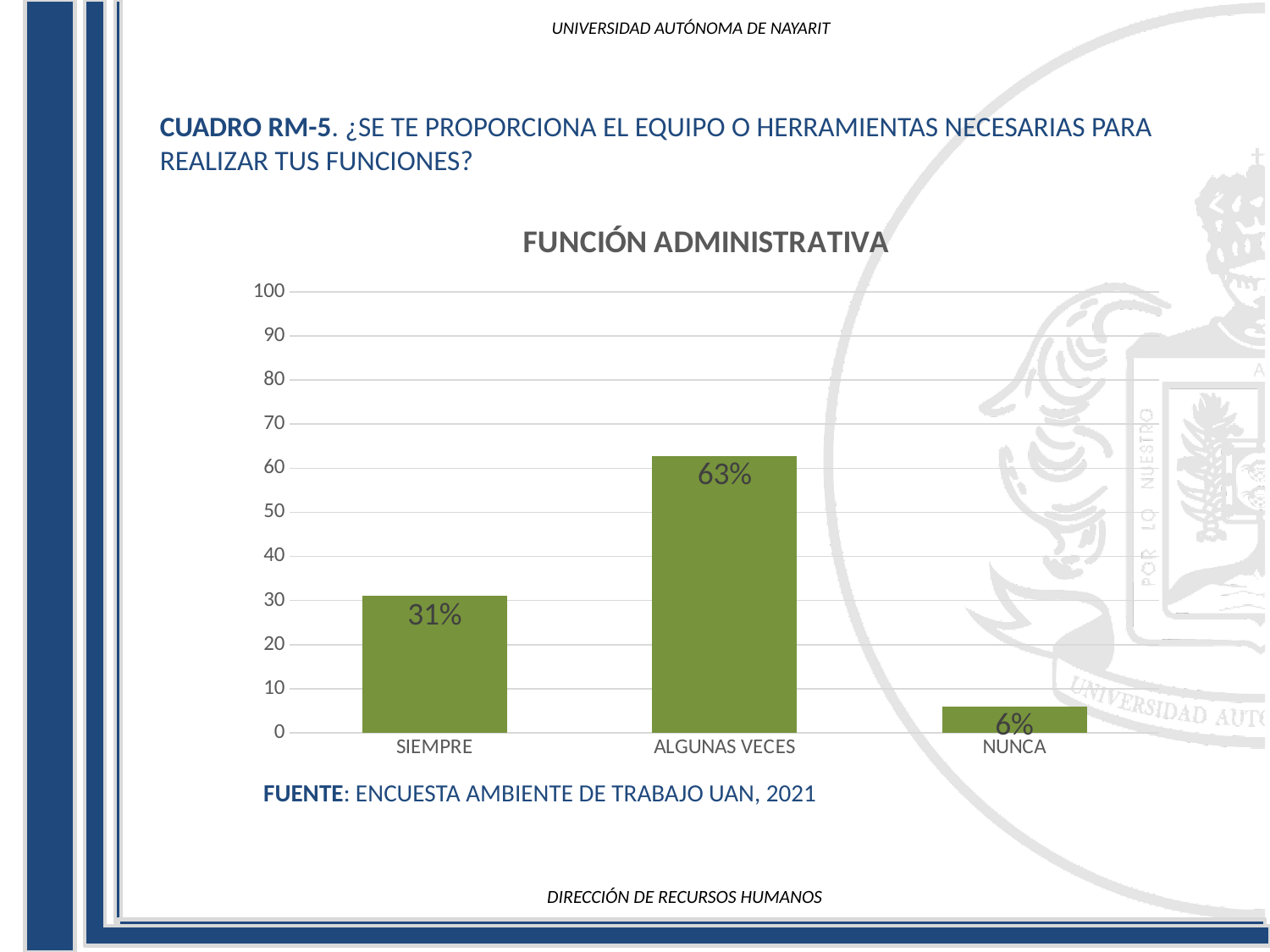
Which category has the lowest value? NUNCA What is the value for NUNCA? 6% Which category has the highest value? ALGUNAS VECES What is the value for ALGUNAS VECES? 63% What is the value for SIEMPRE? 31% Which is larger, the value for SIEMPRE or the value for NUNCA? SIEMPRE What is the title of the chart? FUNCIÓN ADMINISTRATIVA How many categories are shown on the x axis? 3 What is the difference between the values for SIEMPRE and NUNCA? 25% Is the value for ALGUNAS VECES greater or less than 50? greater What is the difference between the values for ALGUNAS VECES and SIEMPRE? 32% What kind of chart is shown on the slide? bar chart